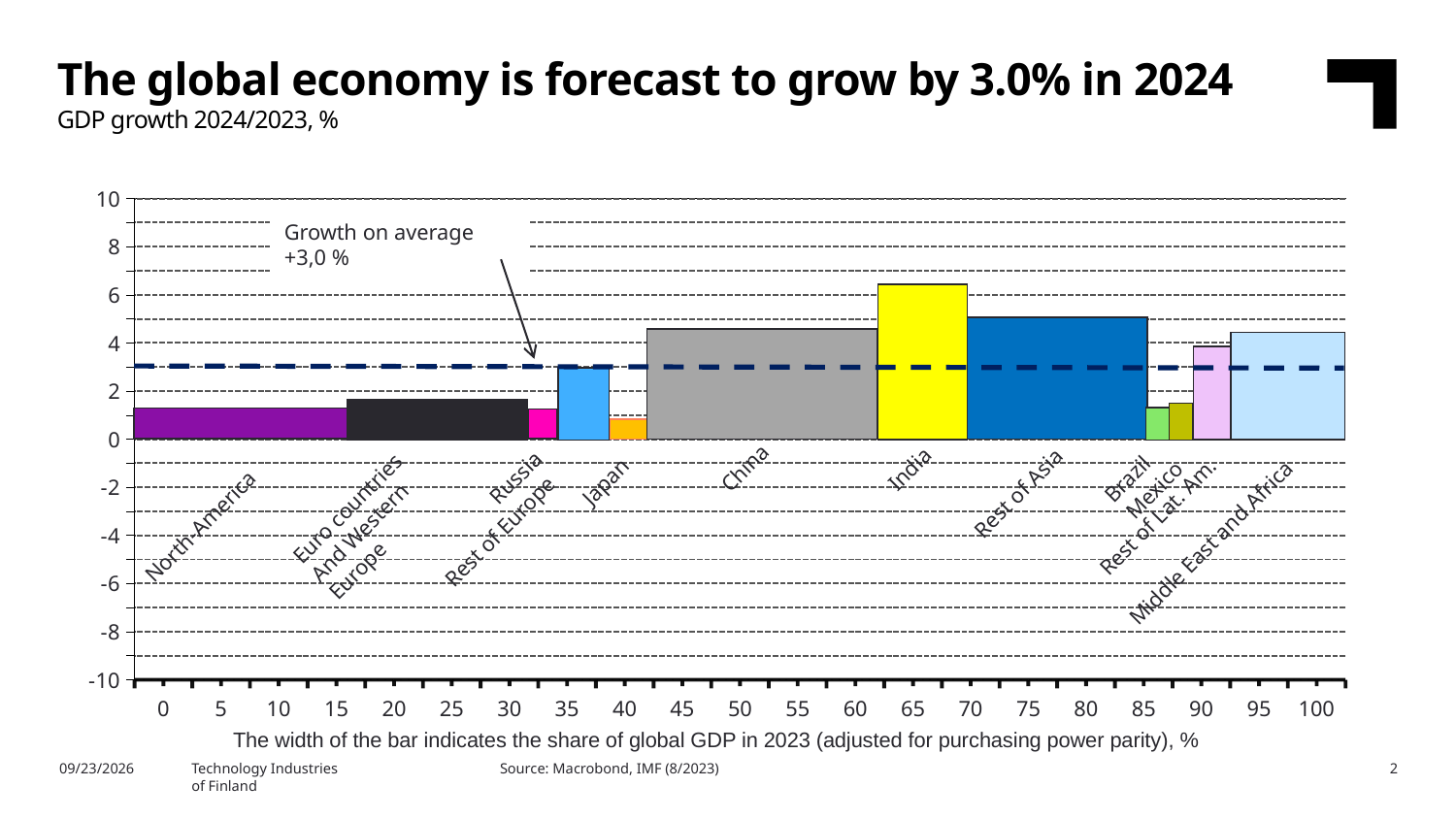
Which has the higher forecast GDP growth, China or India? India How many regions/countries are shown as bars in the chart? 12 According to the note below the chart, what does the width of each bar indicate? The share of global GDP in 2023 (adjusted for purchasing power parity), % Is the value for Japan greater or less than 2? less Is the value for North America greater or less than 2? less Is the value for India greater or less than 6? greater What kind of chart is shown on the slide? bar chart What is the average growth indicated by the dashed line in the chart? +3,0 % Which has the higher forecast GDP growth, Rest of Asia or Euro countries and Western Europe? Rest of Asia Which region has the highest forecast GDP growth in the chart? India